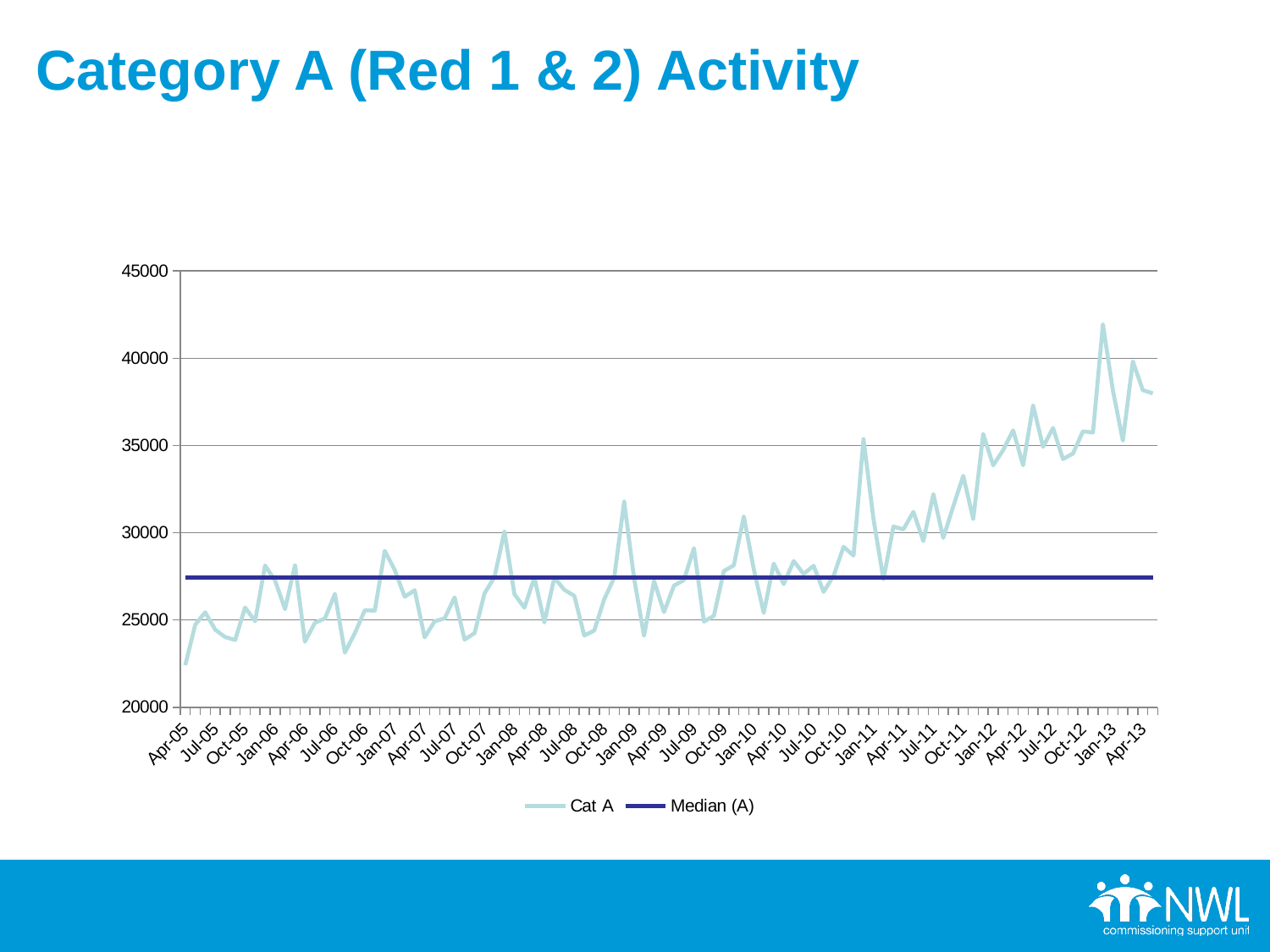
What are the two series named in the legend? Cat A and Median (A) Which is larger, the Cat A value at Apr-05 or the Median (A) value? Median (A) What is the title of the slide containing the chart? Category A (Red 1 & 2) Activity Is the Cat A value at Apr-13 greater or less than 35000? greater Is the Cat A value at Apr-05 greater or less than 25000? less What type of chart is shown on the slide? Line chart Is the Median (A) line greater or less than 25000? greater How many series does the legend list? 2 Around which x-axis label does the Cat A line reach its highest point? Jan-13 Overall, does the Cat A line rise or fall from Apr-05 to Apr-13? Rise